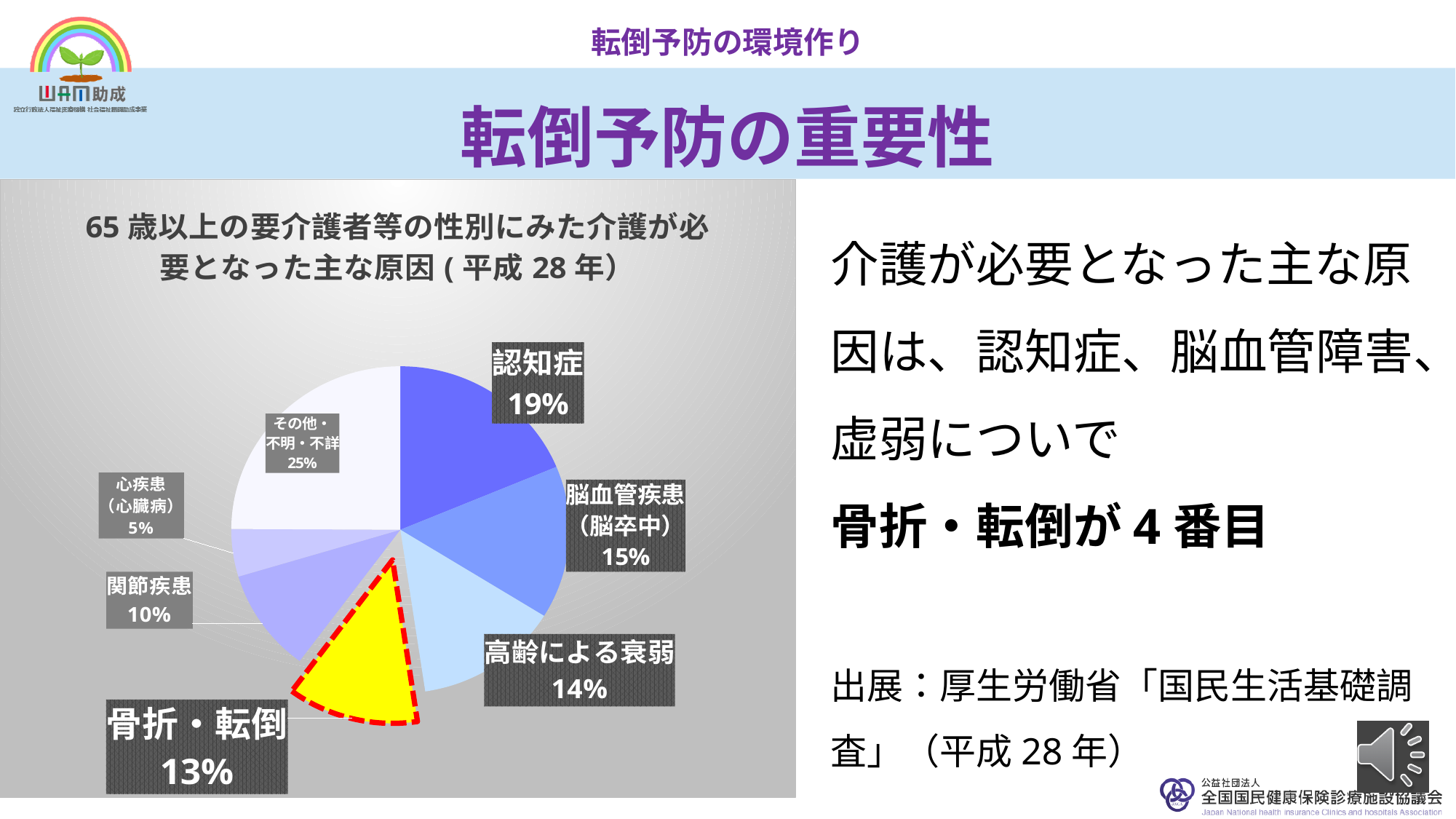
Which slice of the pie is highlighted in yellow with a red dashed outline? 骨折・転倒 Which slice of the pie is the smallest? 心疾患（心臓病） Which is larger, 高齢による衰弱 or 関節疾患? 高齢による衰弱 What percentage of the pie is 心疾患（心臓病）? 5% What is the difference in percentage points between 認知症 and 骨折・転倒? 6 What percentage of the pie is 脳血管疾患（脳卒中）? 15% What kind of chart is shown on the slide? pie chart What percentage of the pie is 関節疾患? 10% What percentage of the pie is 骨折・転倒? 13% How many slices does the pie chart have? 7 Which slice of the pie is the largest? その他・不明・不詳 What percentage of the pie is 認知症? 19%